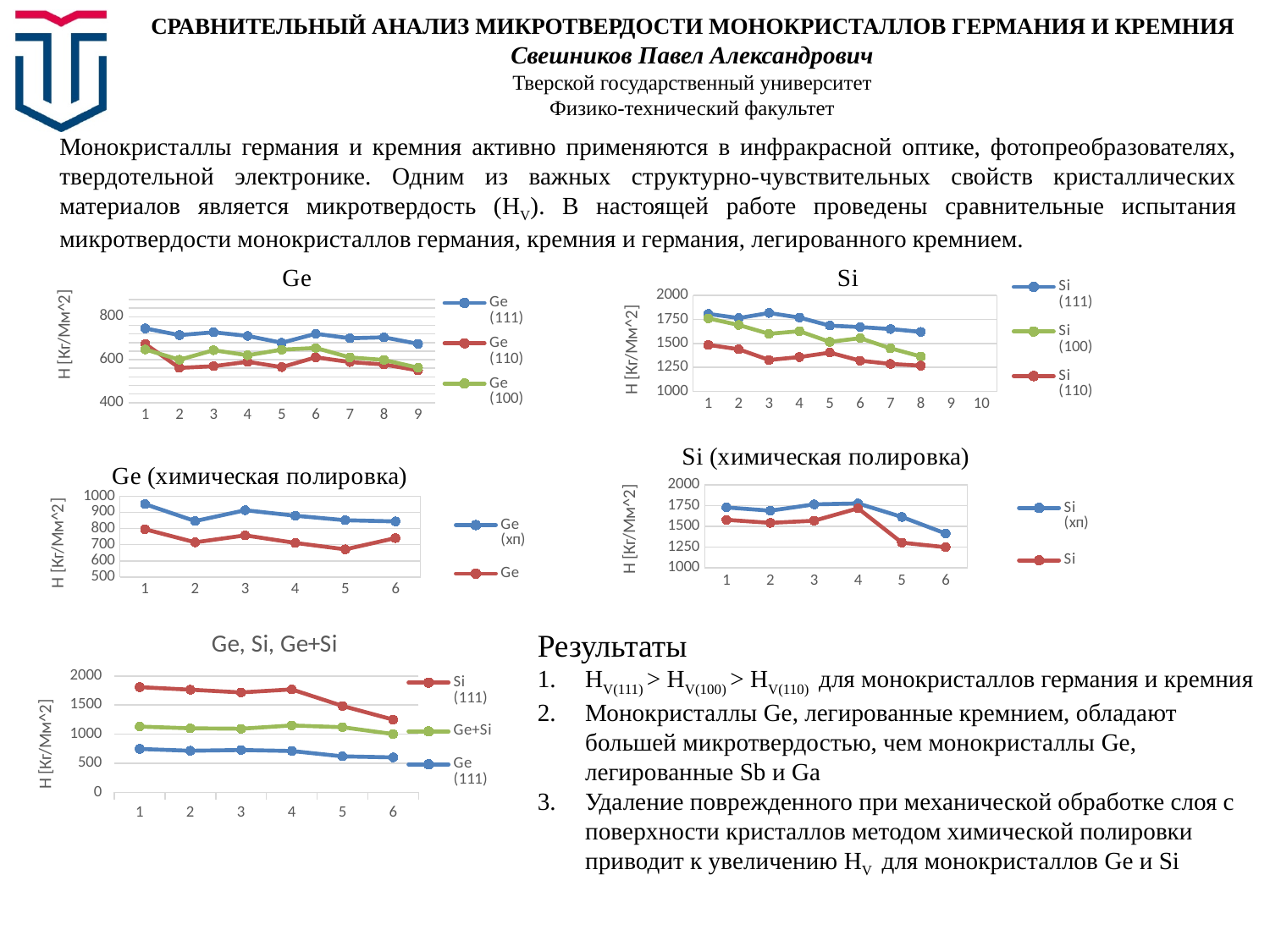
In the chart titled "Ge (химическая полировка)", how many series does the legend list? 2 In the chart titled "Ge", how many points are plotted for the Ge (111) series? 9 In the chart titled "Si", how many series does the legend list? 3 In the chart titled "Si", is the value for Si (110) at point 8 greater or less than 1500? less What kind of chart is the chart titled "Ge"? line chart In the chart titled "Ge (химическая полировка)", how many points are plotted for the Ge (хп) series? 6 What is the y-axis label of the chart titled "Si (химическая полировка)"? H [Кг/Мм^2] In the chart titled "Ge", how many series does the legend list? 3 In the chart titled "Ge, Si, Ge+Si", do the values for Si (111) rise or fall from point 1 to point 6? fall In the chart titled "Ge (химическая полировка)", which series has the larger value at point 1, Ge (хп) or Ge? Ge (хп) In the chart titled "Ge, Si, Ge+Si", is the value for Si (111) at point 1 greater or less than 1500? greater